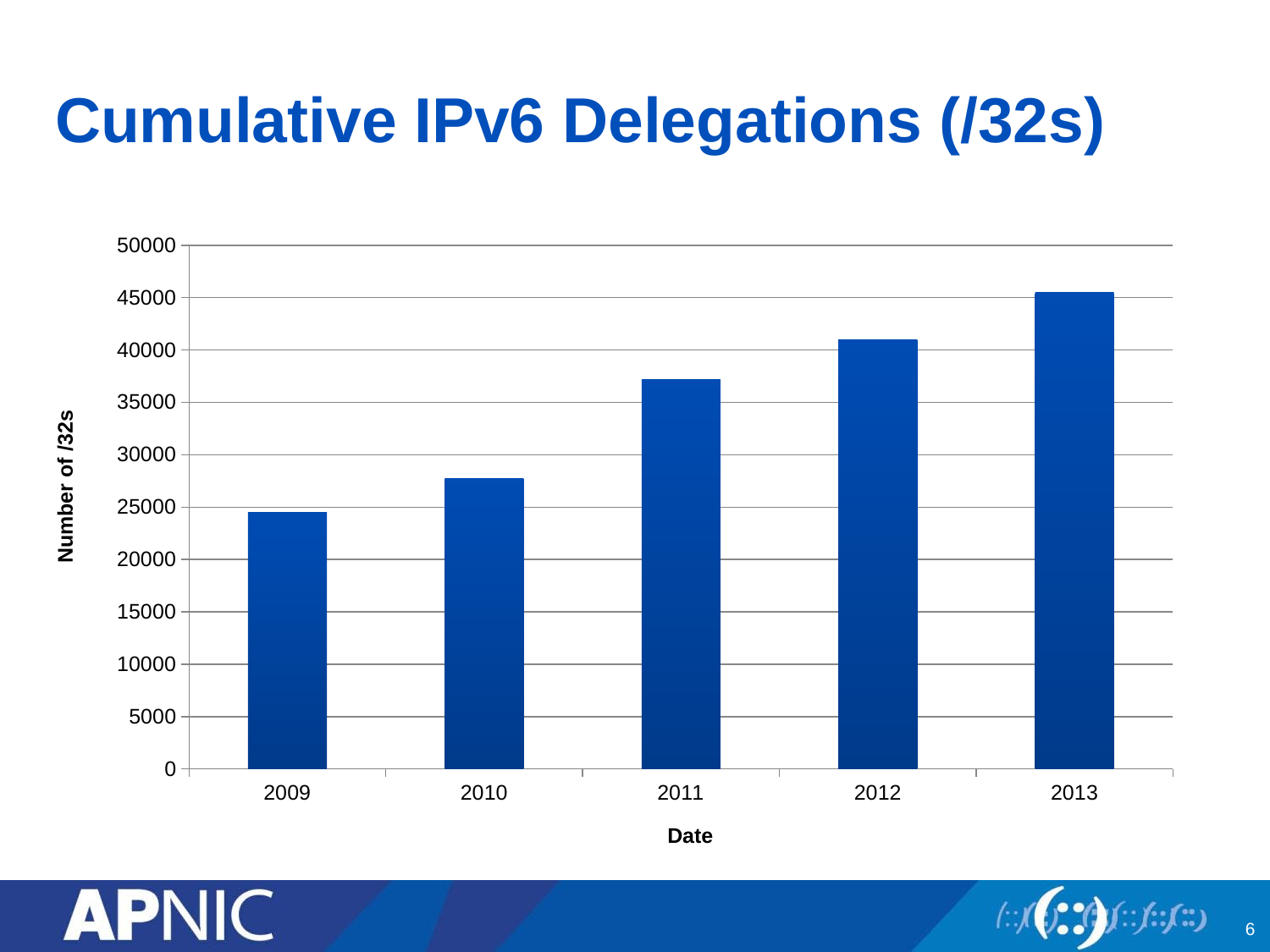
Is the value for 2011 greater or less than 35000? greater What kind of chart is shown on the slide? bar chart How many years are shown on the x axis? 5 Which is larger, the value for 2011 or the value for 2010? 2011 What is the title of the chart? Cumulative IPv6 Delegations (/32s) What is the label of the y axis? Number of /32s Is the value for 2010 greater or less than 30000? less Do the values rise or fall from 2009 to 2013? rise Which year has the highest number of /32s? 2013 Is the value for 2009 greater or less than 20000? greater Which year has the lowest number of /32s? 2009